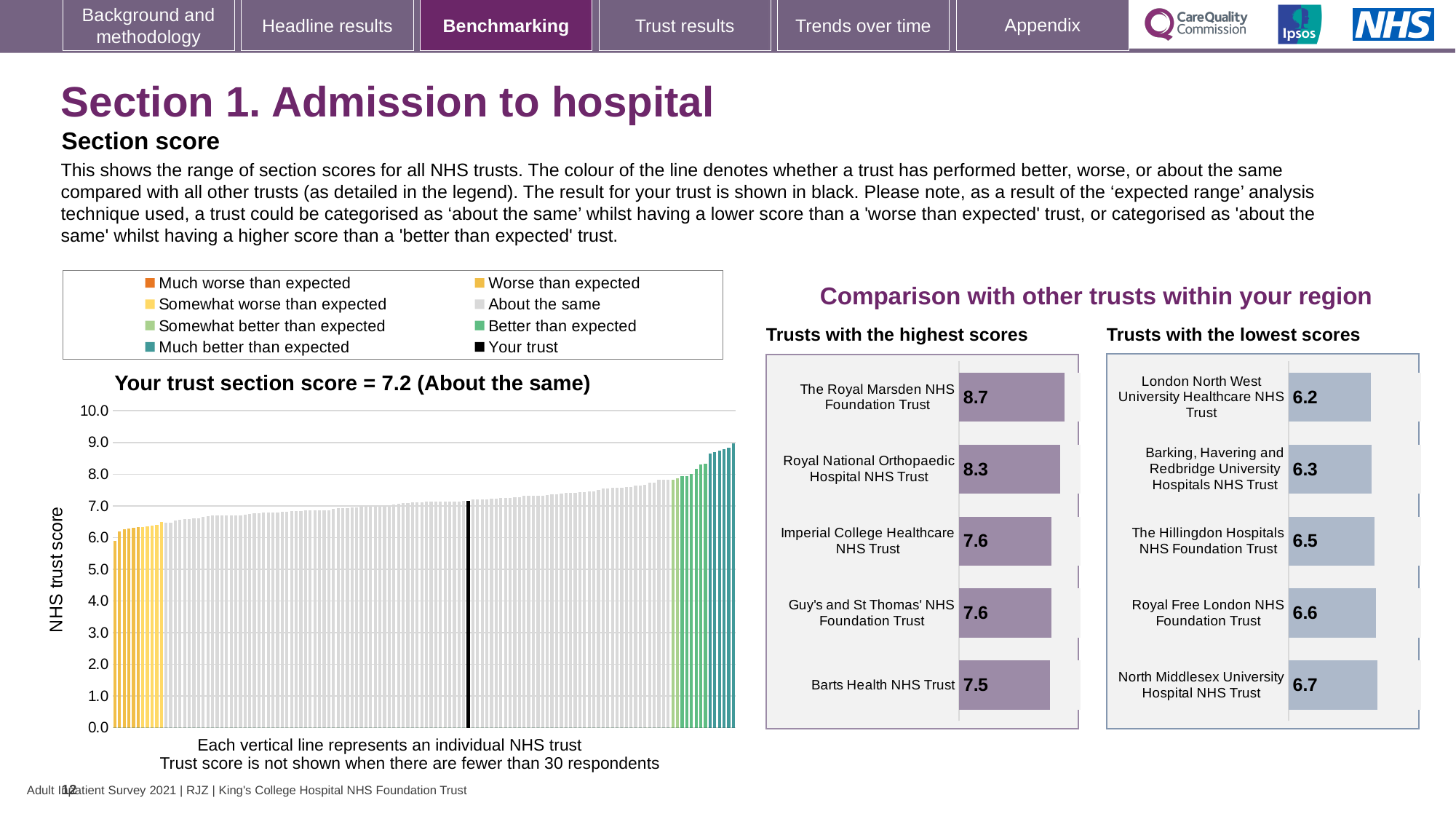
On the 'Trusts with the lowest scores' chart, which has the larger score: Royal Free London NHS Foundation Trust or Barking, Havering and Redbridge University Hospitals NHS Trust? Royal Free London NHS Foundation Trust On the 'Trusts with the highest scores' chart, which trust has the lowest score shown? Barts Health NHS Trust On the 'Trusts with the highest scores' chart, what is the difference between the scores of The Royal Marsden NHS Foundation Trust and Barts Health NHS Trust? 1.2 On the 'Trusts with the lowest scores' chart, which trust has the lowest score? London North West University Healthcare NHS Trust On the 'Trusts with the lowest scores' chart, which trust has the highest score shown? North Middlesex University Hospital NHS Trust On the 'Trusts with the lowest scores' chart, what is the difference between the scores of North Middlesex University Hospital NHS Trust and London North West University Healthcare NHS Trust? 0.5 On the 'Your trust section score' chart on the left, what is the section score for your trust? 7.2 On the 'Trusts with the highest scores' chart, how many trusts are listed? 5 On the 'Your trust section score' chart on the left, do the trust scores rise or fall from left to right? rise On the 'Trusts with the lowest scores' chart, what is the score for The Hillingdon Hospitals NHS Foundation Trust? 6.5 On the 'Trusts with the highest scores' chart, what is the score for The Royal Marsden NHS Foundation Trust? 8.7 How many entries does the legend above the 'Your trust section score' chart list? 8